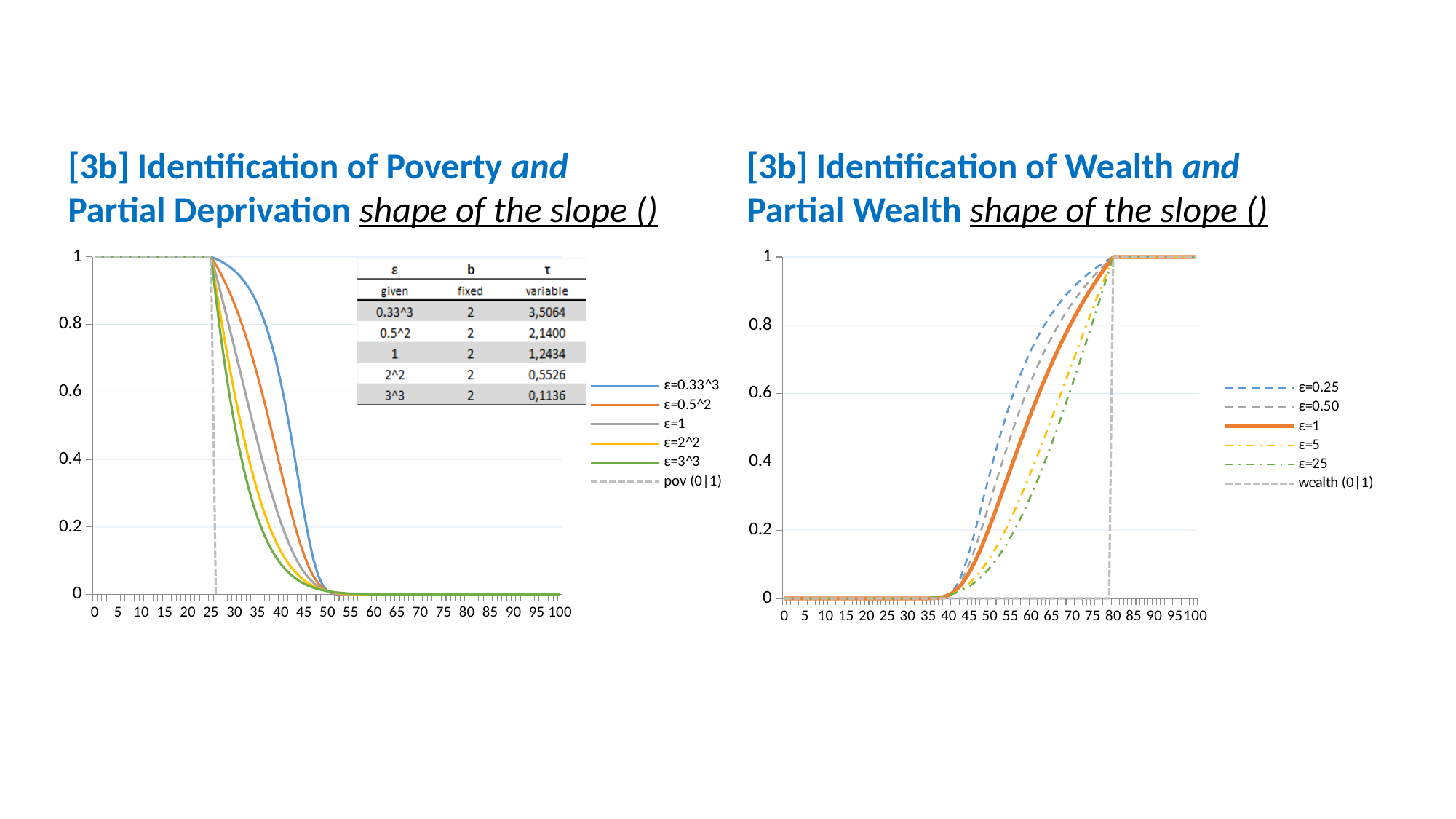
In the right chart (Wealth and Partial Wealth), is the value of the ε=1 series at x=50 greater or less than 0.6? less What kind of chart is the right chart, 'Identification of Wealth and Partial Wealth'? line chart In the right chart (Wealth and Partial Wealth), at x=55, which series has the higher value: ε=0.25 or ε=25? ε=0.25 In the right chart (Wealth and Partial Wealth), do the ε curves rise or fall as the x axis increases from 40 to 80? rise In the left chart (Poverty and Partial Deprivation), at x=40, which series has the higher value: ε=0.33^3 or ε=3^3? ε=0.33^3 How many series does the legend of the left chart (Poverty and Partial Deprivation) list? 6 In the right chart (Wealth and Partial Wealth), which series is drawn as a thick solid orange line? ε=1 In the left chart (Poverty and Partial Deprivation), is the value of the ε=3^3 series at x=35 greater or less than 0.6? less How many series does the legend of the right chart (Wealth and Partial Wealth) list? 6 What kind of chart is the left chart, 'Identification of Poverty and Partial Deprivation'? line chart In the left chart (Poverty and Partial Deprivation), do the ε curves rise or fall as the x axis increases from 25 to 55? fall In the left chart (Poverty and Partial Deprivation), is the value of the ε=0.33^3 series at x=30 greater or less than 0.8? greater